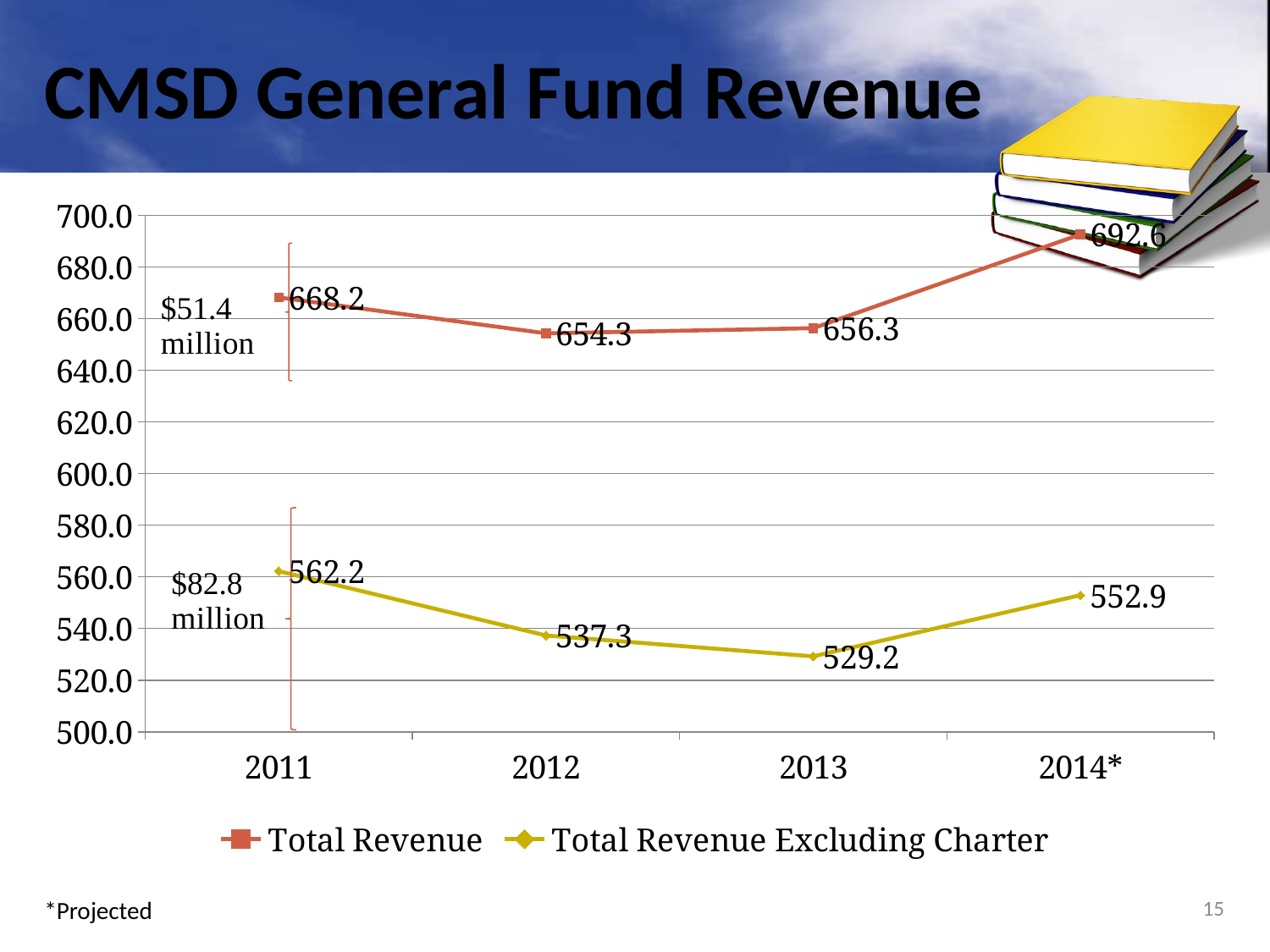
Does Total Revenue Excluding Charter rise or fall from 2011 to 2013? Fall What is the difference between Total Revenue and Total Revenue Excluding Charter in 2011? 106.0 What is the Total Revenue Excluding Charter value for 2013? 529.2 What kind of chart is shown on the slide? Line chart In which year is Total Revenue highest? 2014* What is the Total Revenue value for 2014*? 692.6 In which year is Total Revenue Excluding Charter lowest? 2013 What is the Total Revenue value for 2012? 654.3 Which is larger: Total Revenue in 2011 or Total Revenue in 2013? Total Revenue in 2011 What is the title of the chart? CMSD General Fund Revenue How many years are shown on the x axis? 4 How many series does the legend list? 2